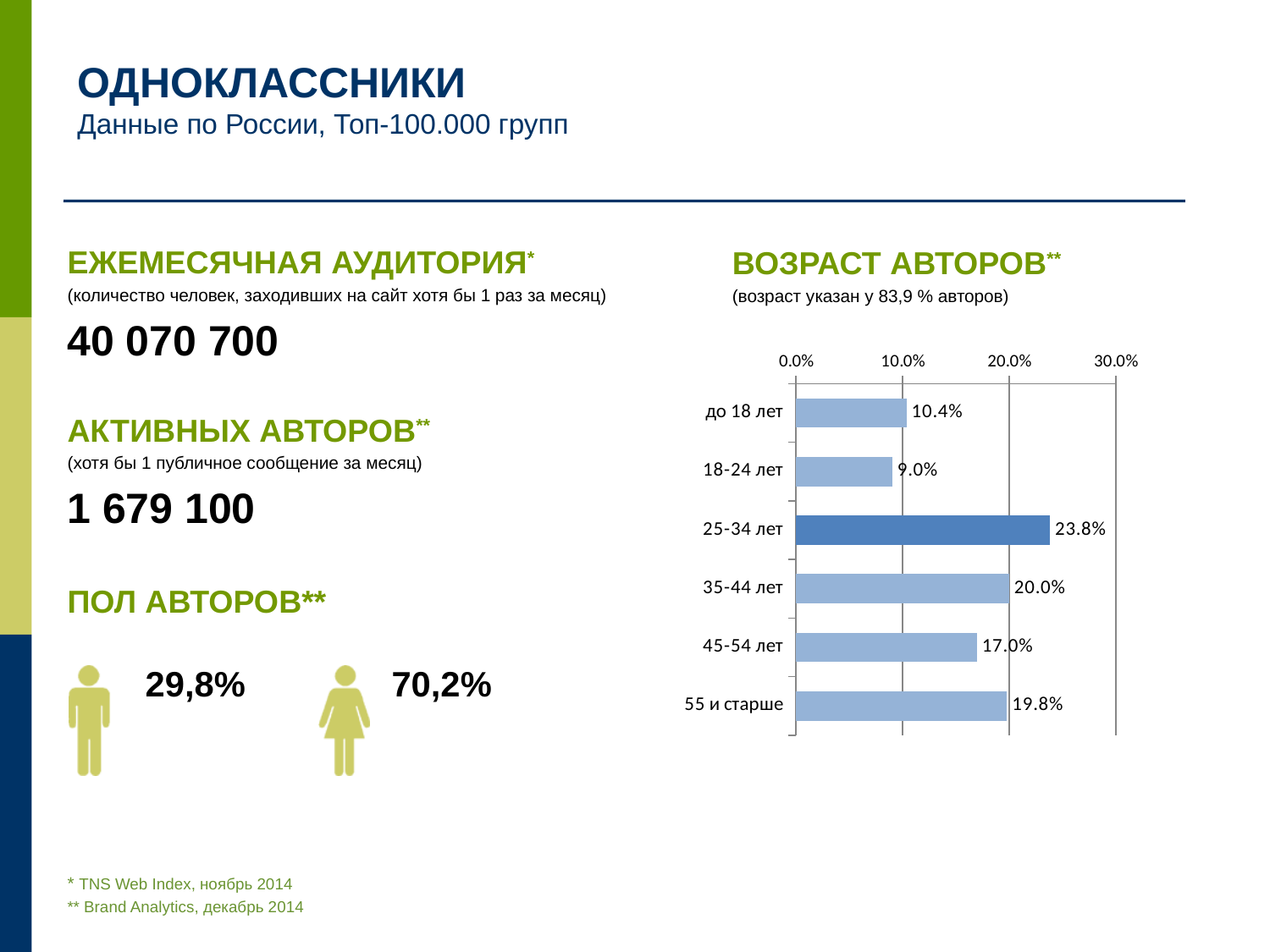
Which is larger in the ВОЗРАСТ АВТОРОВ chart: the value for 45-54 лет or for 55 и старше? 55 и старше What is the value for the 25-34 лет category in the ВОЗРАСТ АВТОРОВ chart? 23.8% Which age category has the highest value in the ВОЗРАСТ АВТОРОВ chart? 25-34 лет What is the value for the 55 и старше category in the ВОЗРАСТ АВТОРОВ chart? 19.8% How many age categories are shown in the ВОЗРАСТ АВТОРОВ chart? 6 What is the difference between the values for 25-34 лет and 35-44 лет in the ВОЗРАСТ АВТОРОВ chart? 3.8% What is the value for the до 18 лет category in the ВОЗРАСТ АВТОРОВ chart? 10.4% What kind of chart is the ВОЗРАСТ АВТОРОВ chart? bar chart What is the highest value shown on the axis of the ВОЗРАСТ АВТОРОВ chart? 30.0% Which bar in the ВОЗРАСТ АВТОРОВ chart is shown in a darker blue than the others? 25-34 лет Is the value for 35-44 лет in the ВОЗРАСТ АВТОРОВ chart greater or less than 10.0%? greater Which age category has the lowest value in the ВОЗРАСТ АВТОРОВ chart? 18-24 лет